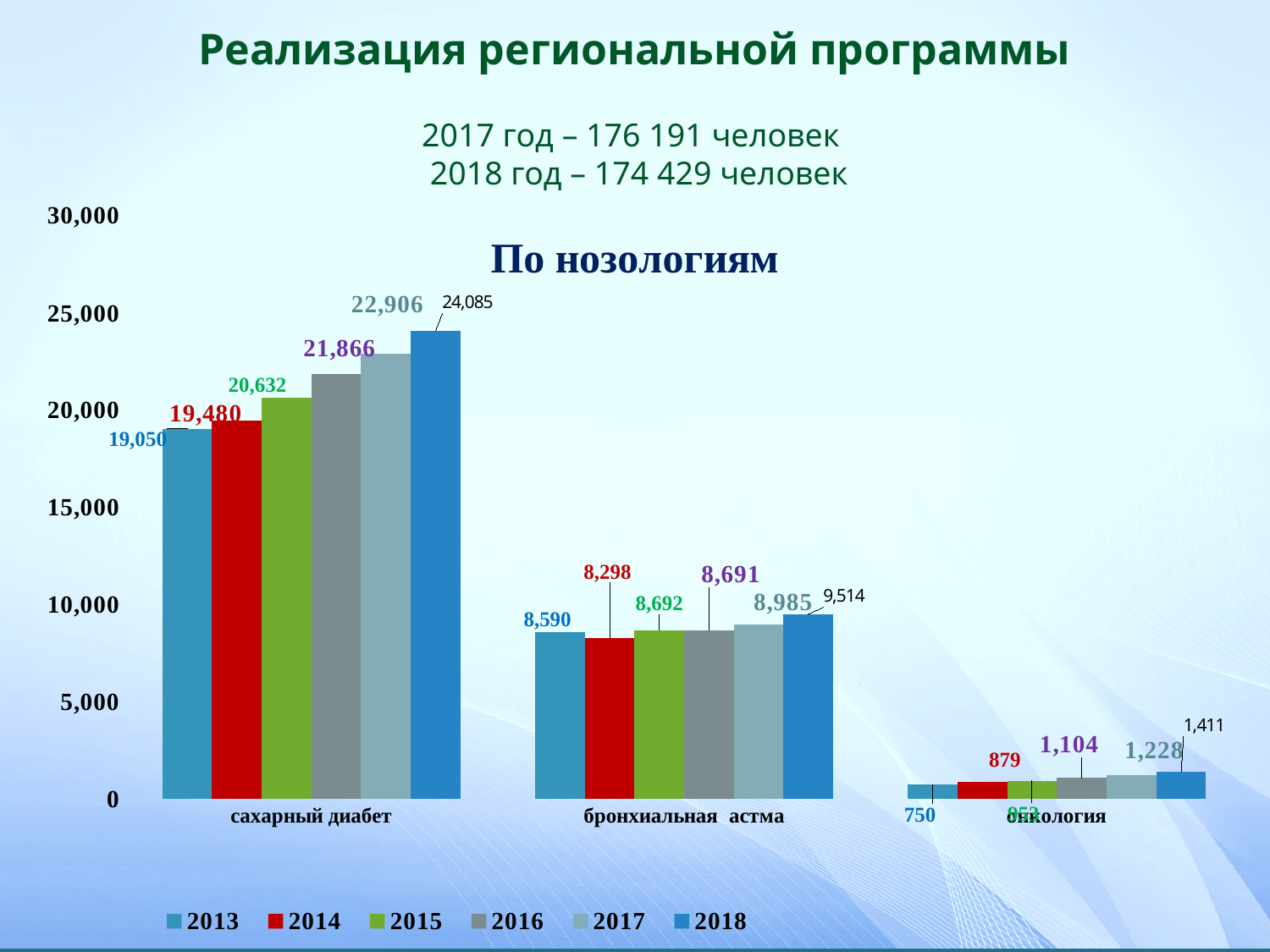
What kind of chart is shown on the slide? bar chart How many categories are shown on the x axis? 3 What is the value for 2013 in the бронхиальная астма category? 8,590 How many series does the legend list? 6 What is the difference between the 2018 and 2013 values for сахарный диабет? 5,035 What is the title of the chart? По нозологиям What is the value for 2017 in the онкология category? 1,228 Is the value for 2018 in the бронхиальная астма category greater or less than 10,000? less What is the value for 2018 in the сахарный диабет category? 24,085 Which is larger for онкология: the value for 2014 or the value for 2016? 2016 Which year has the highest value in the сахарный диабет category? 2018 Which year has the lowest value in the бронхиальная астма category? 2014